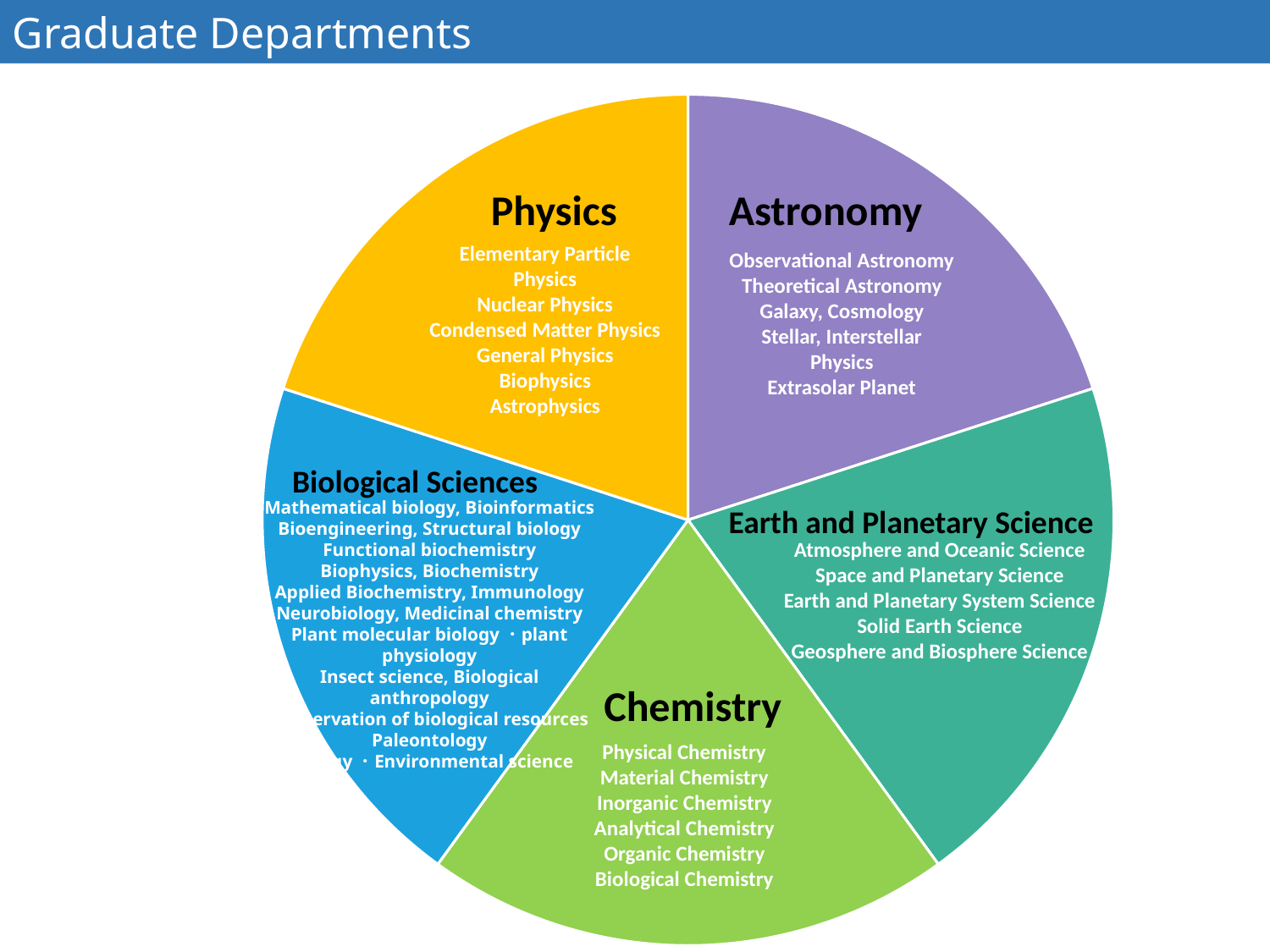
What colour is the Physics slice of the pie chart? yellow How many slices does the pie chart have? 5 What kind of chart is shown on the slide? pie chart What is the title of the slide containing the pie chart? Graduate Departments Which slice is larger, Biological Sciences or Chemistry? Neither; they are the same size Which slice is larger, Biological Sciences or Physics? Neither; they are the same size